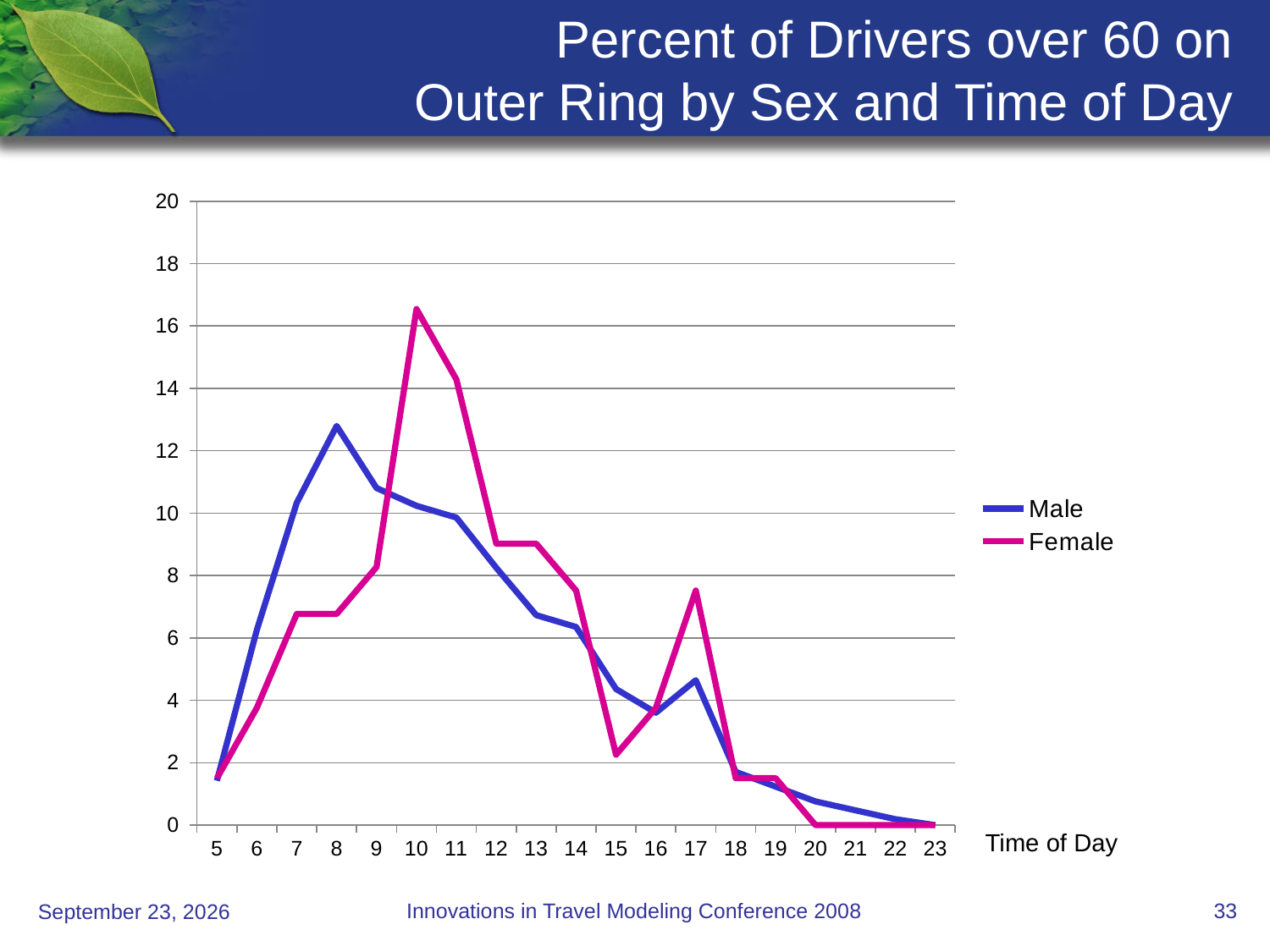
Is the value for Female at 15 greater or less than 4? less How many time-of-day points are plotted along the x axis? 19 At which time of day does the Female series reach its highest value? 10 At which time of day does the Male series reach its highest value? 8 What kind of chart is shown on the slide? Line chart Is the value for Male at 8 greater or less than 12? greater How many series does the legend list? 2 Is the value for Male at 5 greater or less than 2? less What is the label of the x axis? Time of Day At 10, which series has the higher value, Male or Female? Female At 8, which series has the higher value, Male or Female? Male